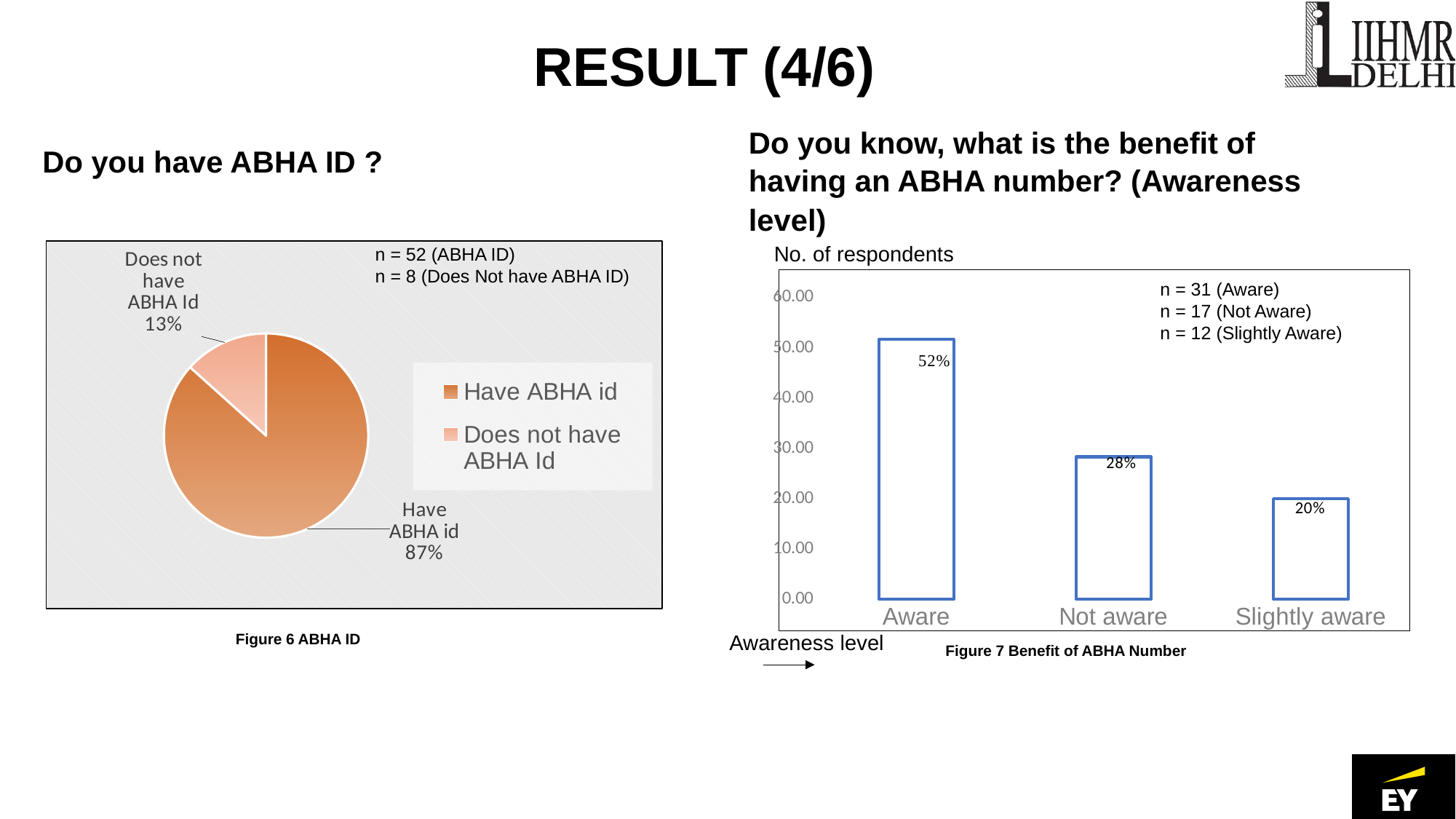
In the bar chart (Figure 7 Benefit of ABHA Number), is the value for Not aware greater or less than 30.00? less What type of chart is Figure 6 ABHA ID? Pie chart What type of chart is Figure 7 Benefit of ABHA Number? Bar chart In the pie chart (Figure 6 ABHA ID), which slice is the largest? Have ABHA id In the pie chart (Figure 6 ABHA ID), what share of respondents do not have an ABHA Id? 13% In the bar chart (Figure 7 Benefit of ABHA Number), which awareness level has the highest bar? Aware In the pie chart (Figure 6 ABHA ID), what share of respondents have an ABHA id? 87% In the bar chart (Figure 7 Benefit of ABHA Number), which awareness level has the lowest bar? Slightly aware In the bar chart (Figure 7 Benefit of ABHA Number), what is the data label on the Slightly aware bar? 20% In the bar chart (Figure 7 Benefit of ABHA Number), what is the data label on the Aware bar? 52% In the pie chart (Figure 6 ABHA ID), how many slices are there? 2 In the bar chart (Figure 7 Benefit of ABHA Number), how many categories are shown on the x axis? 3